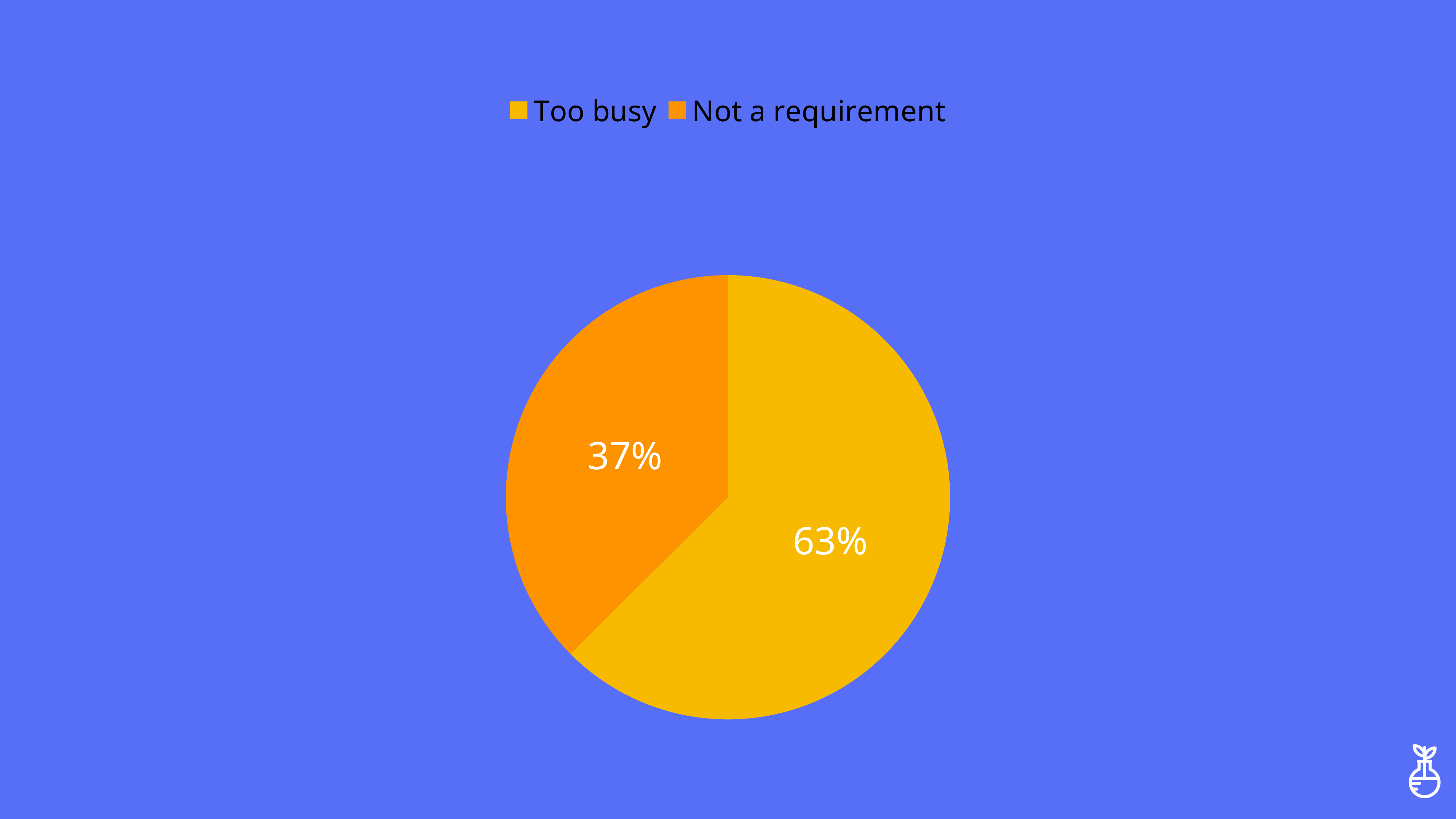
What colour is the "Too busy" slice? yellow What kind of chart is shown on the slide? pie chart Which slice is the smallest? Not a requirement What percentage of the pie is labelled "Too busy"? 63% What percentage of the pie is labelled "Not a requirement"? 37% Which slice is the largest? Too busy How many entries does the legend list? 2 What share of the pie does the "Not a requirement" slice represent? 37% Where is the legend positioned relative to the pie? above the pie How many slices does the pie chart have? 2 Which is larger, the "Too busy" slice or the "Not a requirement" slice? Too busy What is the difference in percentage points between the "Too busy" and "Not a requirement" slices? 26